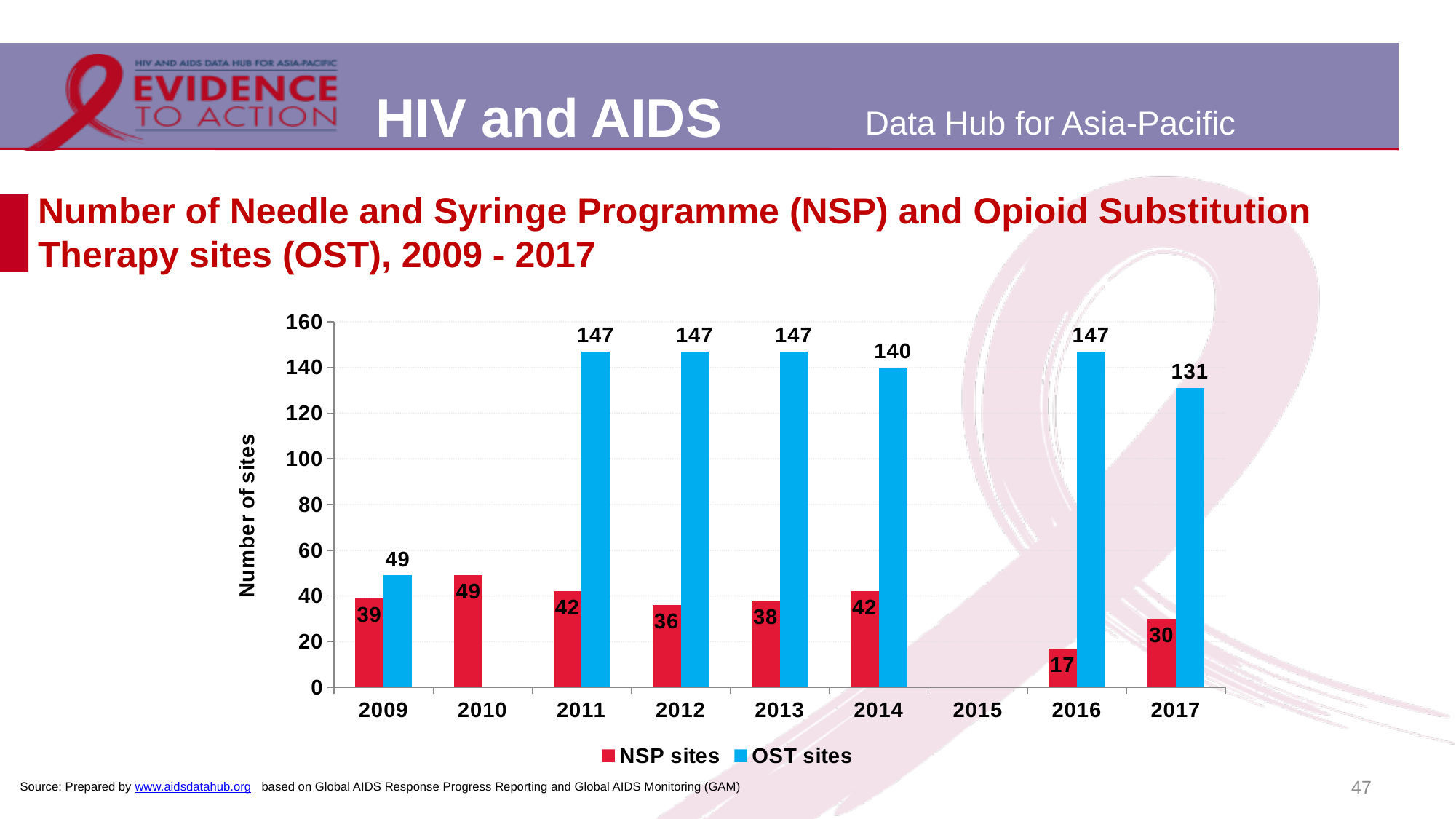
In which year is the number of OST sites lowest? 2009 How many series does the legend list? 2 How many years are shown on the x axis? 9 In 2009, which is larger: the number of NSP sites or the number of OST sites? OST sites What is the number of NSP sites in 2009? 39 In which year is the number of NSP sites highest? 2010 What kind of chart is shown on the slide? Bar chart What is the number of OST sites in 2017? 131 In which year is the number of NSP sites lowest? 2016 What is the difference between the number of OST sites and NSP sites in 2017? 101 What is the number of OST sites in 2014? 140 By how much did the number of OST sites fall from 2016 to 2017? 16